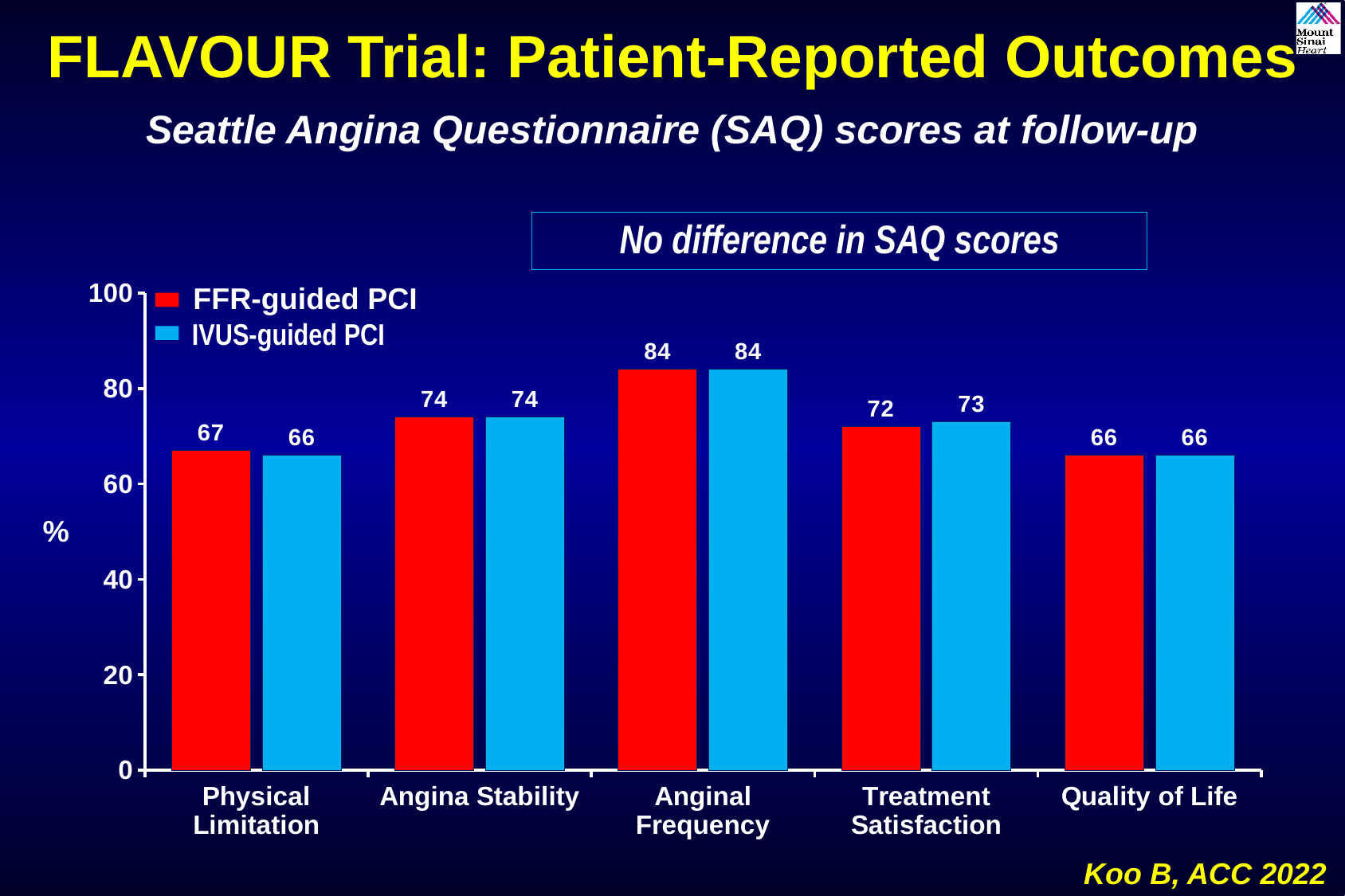
What is the difference between the FFR-guided PCI values for Anginal Frequency and Quality of Life? 18 Is the IVUS-guided PCI value for Anginal Frequency greater or less than 80? greater What kind of chart is shown on the slide? bar chart What is the difference between the FFR-guided PCI and IVUS-guided PCI values for Physical Limitation? 1 What is the FFR-guided PCI value for Physical Limitation? 67 Which category has the highest FFR-guided PCI value? Anginal Frequency Which is larger: the FFR-guided PCI value for Angina Stability or the FFR-guided PCI value for Treatment Satisfaction? Angina Stability How many series does the legend list? 2 What is the IVUS-guided PCI value for Treatment Satisfaction? 73 Which category has the lowest IVUS-guided PCI value? Physical Limitation and Quality of Life (tied at 66) What is the IVUS-guided PCI value for Quality of Life? 66 How many categories are shown on the x axis? 5